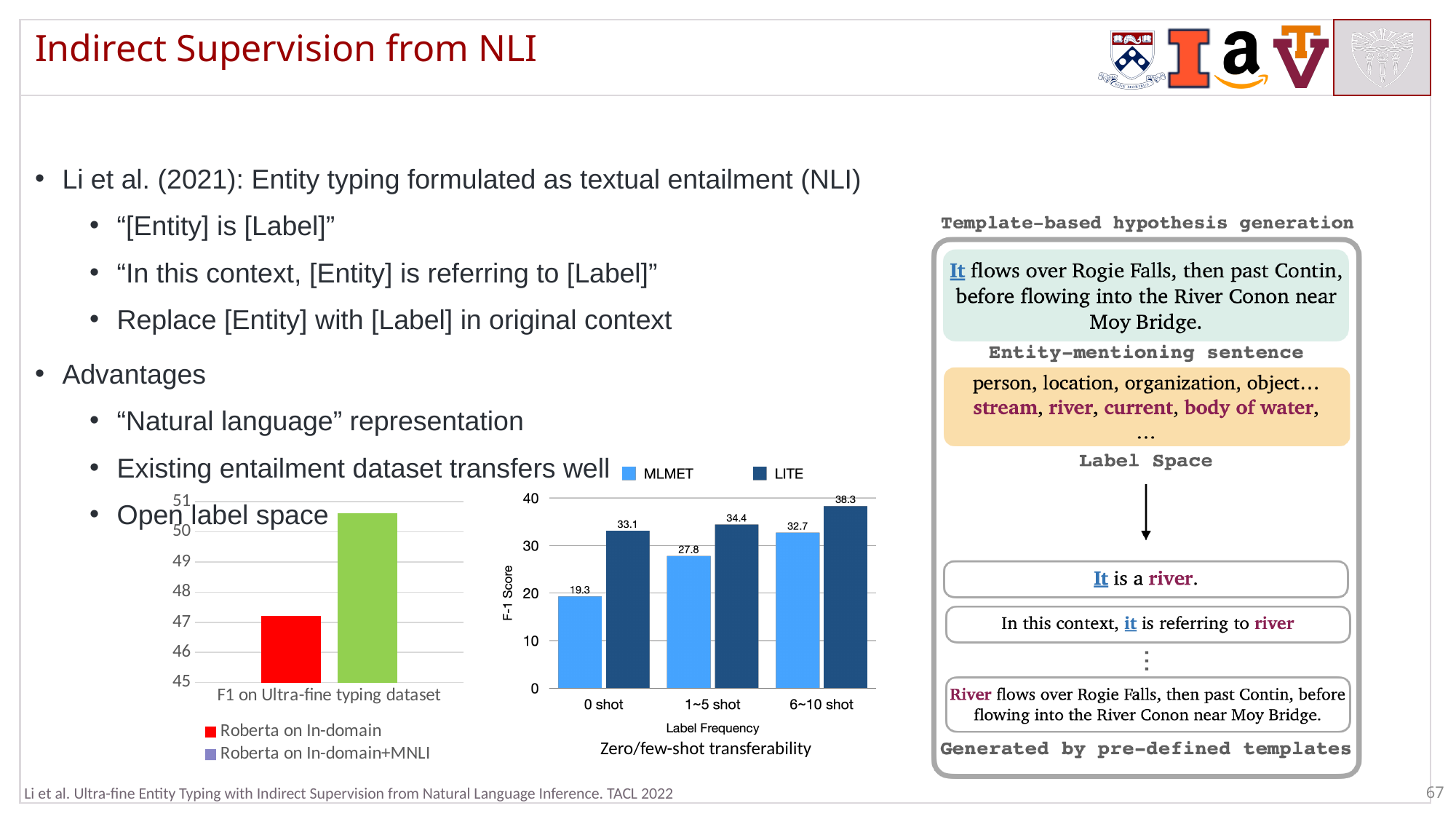
What kind of chart is the F1 on Ultra-fine typing dataset chart? bar chart In the Zero/few-shot transferability chart, what is the difference between LITE and MLMET at 6~10 shot? 5.6 In the Zero/few-shot transferability chart, which label frequency group has the lowest MLMET score? 0 shot In the Zero/few-shot transferability chart, how many series does the legend list? 2 In the F1 on Ultra-fine typing dataset chart, is the value for Roberta on In-domain+MNLI greater or less than 50? greater In the Zero/few-shot transferability chart, what is the F-1 score of MLMET at 1~5 shot? 27.8 In the Zero/few-shot transferability chart, what is the F-1 score of MLMET at 0 shot? 19.3 In the F1 on Ultra-fine typing dataset chart, is the value for Roberta on In-domain greater or less than 48? less In the Zero/few-shot transferability chart, do the LITE scores rise or fall as label frequency increases from 0 shot to 6~10 shot? rise In the Zero/few-shot transferability chart, what is the difference between LITE and MLMET at 0 shot? 13.8 In the Zero/few-shot transferability chart, which series has the higher score at 1~5 shot, MLMET or LITE? LITE In the Zero/few-shot transferability chart, what is the F-1 score of LITE at 6~10 shot? 38.3